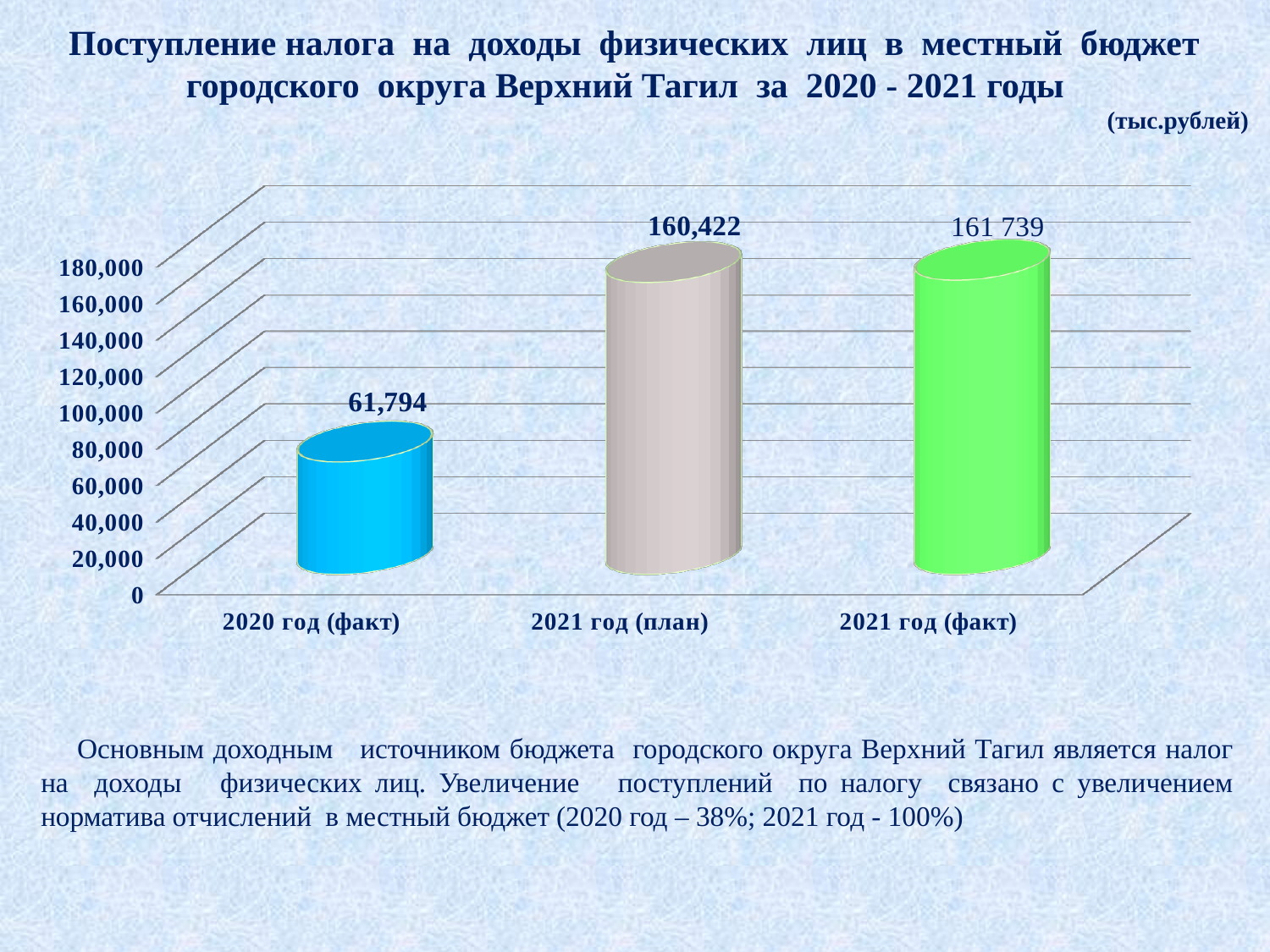
What is the difference between the values for 2021 год (факт) and 2021 год (план)? 1,317 Is the value for 2020 год (факт) greater or less than 80,000? less Which category has the lowest value? 2020 год (факт) What is the value for 2021 год (план)? 160,422 What is the difference between the values for 2021 год (план) and 2020 год (факт)? 98,628 What is the value for 2021 год (факт)? 161 739 Which is larger, the value for 2021 год (план) or the value for 2020 год (факт)? 2021 год (план) How many categories are shown on the x axis? 3 What is the value for 2020 год (факт)? 61,794 In what units are the values on the chart given? тыс.рублей Which category has the highest value? 2021 год (факт) What kind of chart is shown on the slide? bar chart